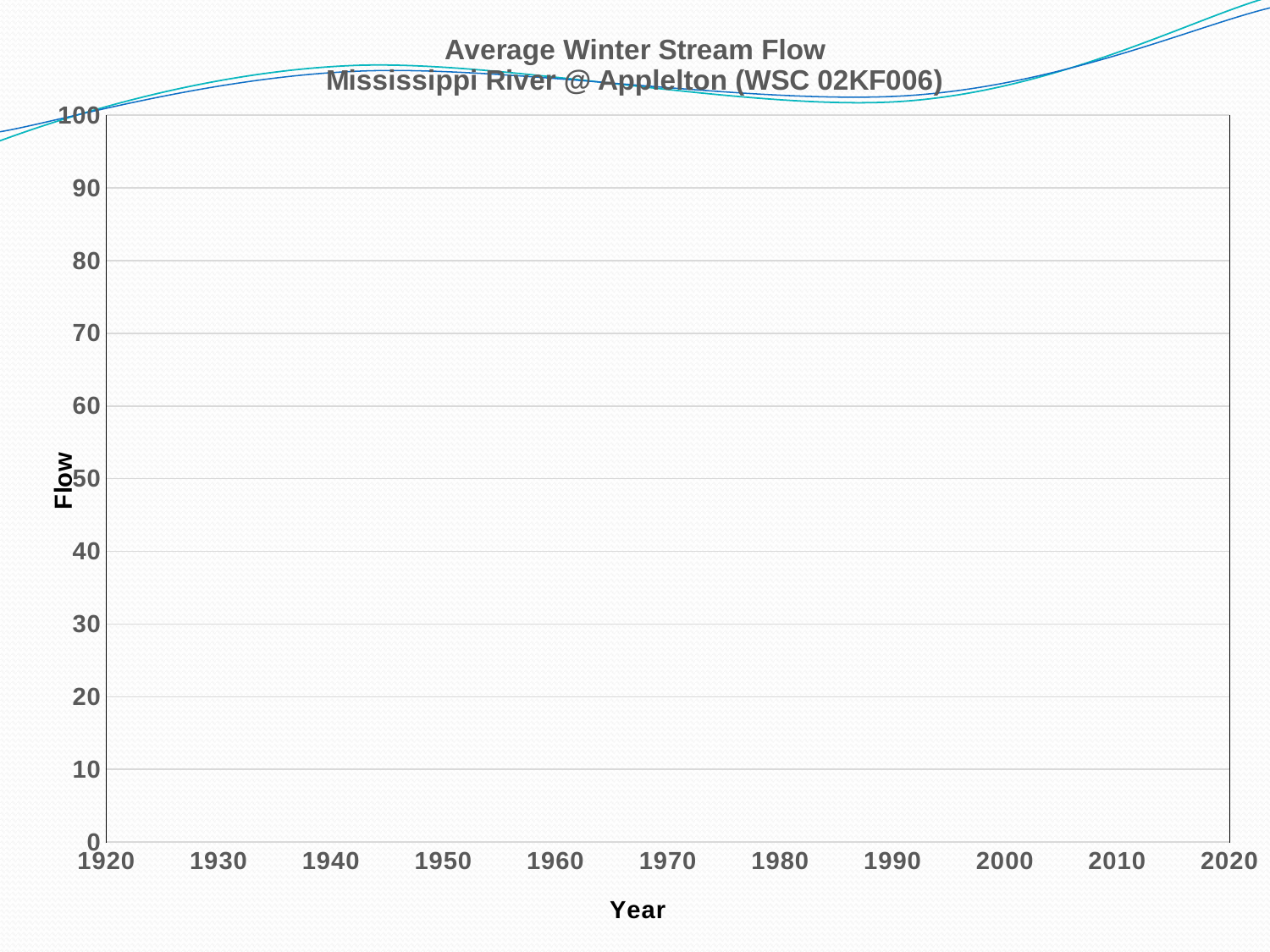
Do the plotted lines rise or fall between 1950 and 1980? fall What kind of chart is shown on the slide? line chart Do the plotted lines rise or fall between 1990 and 2020? rise Is the plotted value at 1960 greater or less than 100? greater What is the title of the chart? Average Winter Stream Flow Mississippi River @ Applelton (WSC 02KF006) How many lines are plotted on the chart? 2 What is the label on the vertical axis of the chart? Flow Is the plotted value at 2000 greater or less than 90? greater